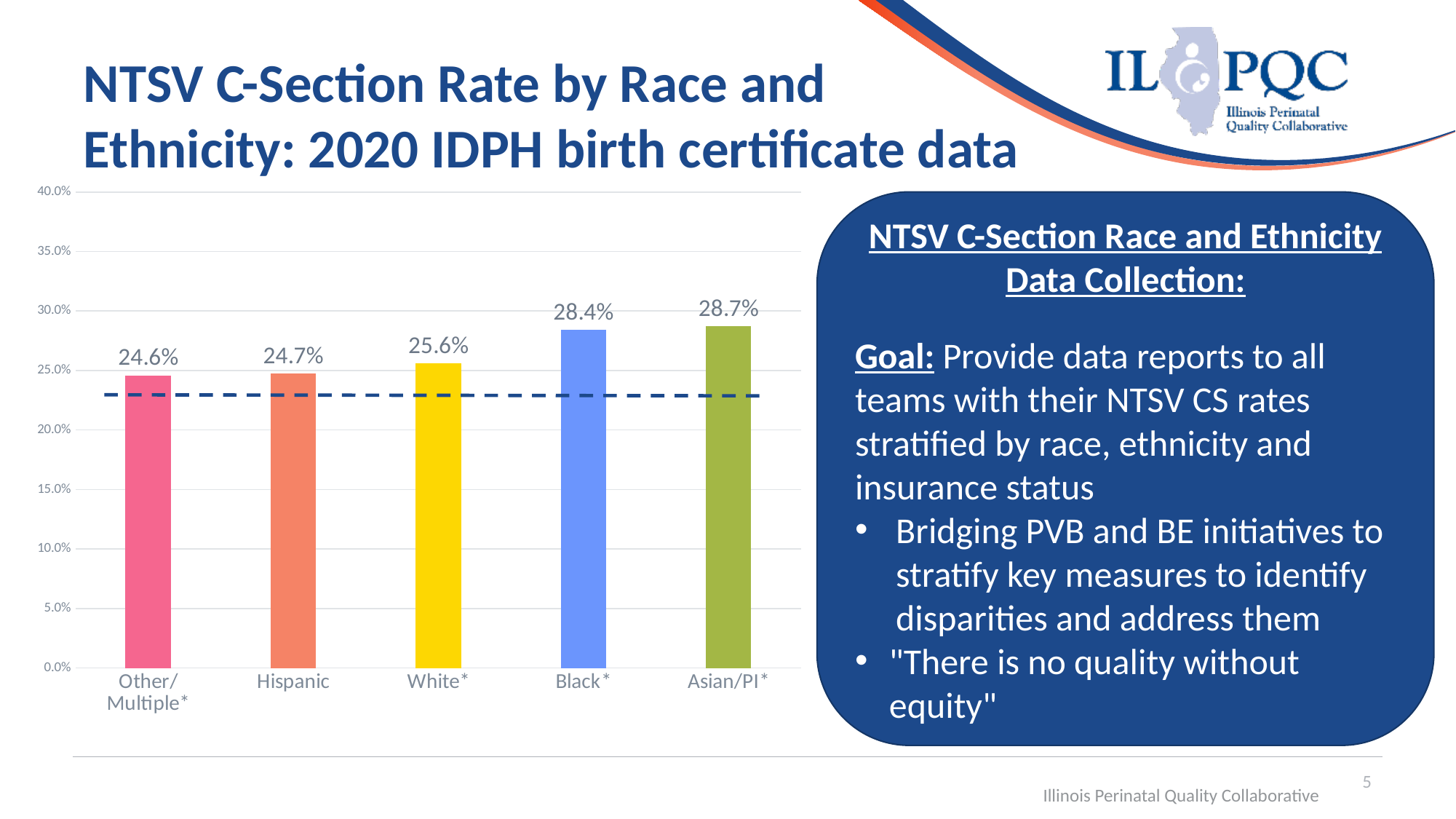
Which has a higher NTSV C-section rate, White* or Black*? Black* What is the NTSV C-section rate for Hispanic? 24.7% What is the difference in NTSV C-section rate between Asian/PI* and Other/Multiple*? 4.1 percentage points What type of chart is used to show the NTSV C-section rates? Bar chart What is the difference in NTSV C-section rate between Black* and White*? 2.8 percentage points What is the NTSV C-section rate for White*? 25.6% Which race/ethnicity category has the highest NTSV C-section rate? Asian/PI* Which race/ethnicity category has the lowest NTSV C-section rate? Other/Multiple* Is the NTSV C-section rate for Black* greater or less than 25.0%? greater Do the NTSV C-section rates rise or fall moving from left to right across the categories? Rise How many race/ethnicity categories are shown in the chart? 5 What is the NTSV C-section rate for Black*? 28.4%